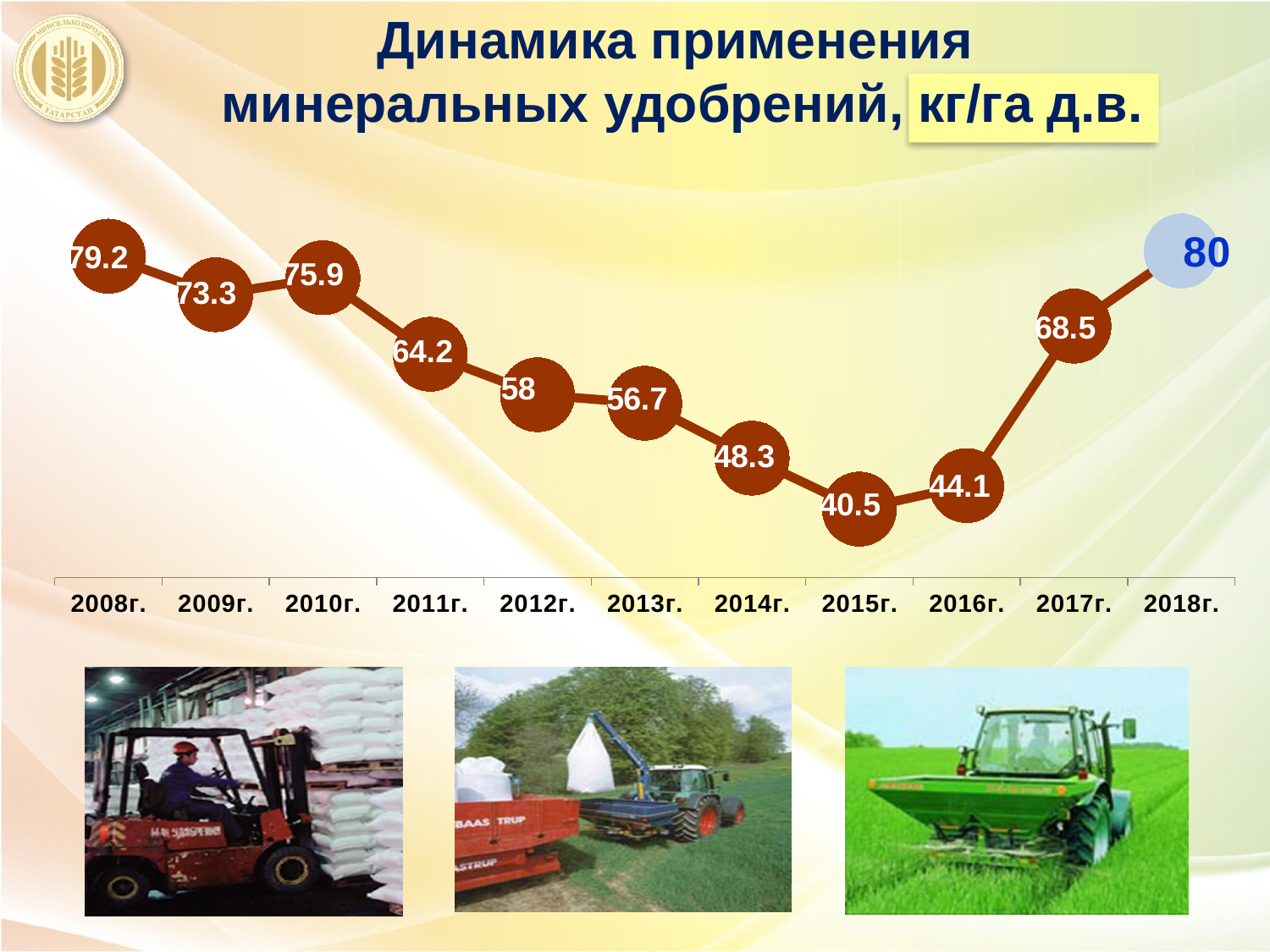
What is the value for 2015г.? 40.5 Do the values rise or fall from 2015г. to 2018г.? rise Which year has the highest value? 2018г. What is the value for 2008г.? 79.2 Which is larger, the value for 2010г. or the value for 2009г.? 2010г. What is the difference between the values for 2018г. and 2017г.? 11.5 What is the value for 2012г.? 58 What kind of chart is shown on the slide? line chart How many years are plotted on the chart? 11 What is the difference between the values for 2008г. and 2015г.? 38.7 Which year has the lowest value? 2015г. What is the value for 2017г.? 68.5